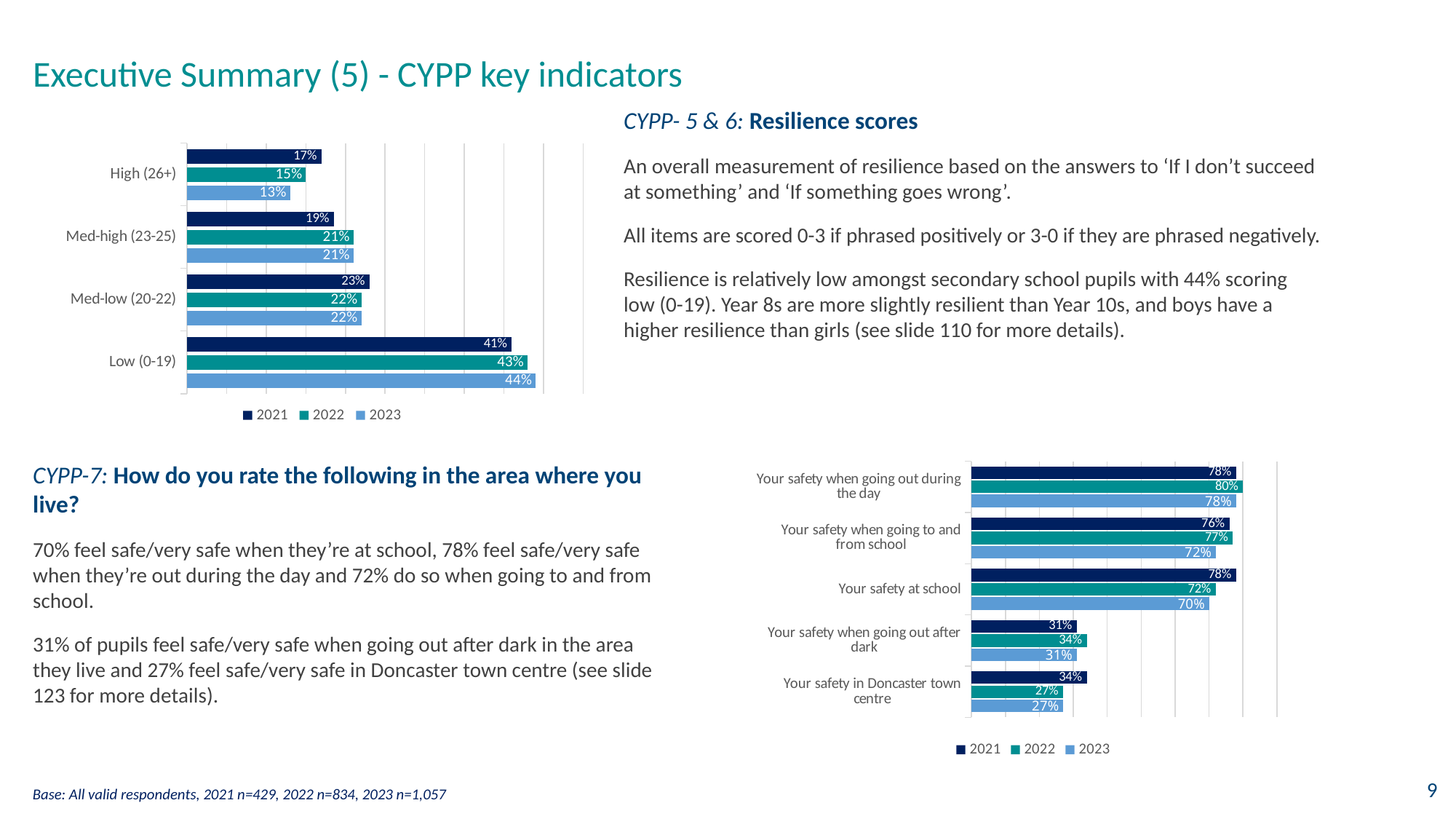
In the bottom-right safety chart, which is larger: the 2021 value for 'Your safety at school' or the 2023 value for 'Your safety at school'? 2021 (78%) In the top-left resilience scores chart, which category has the lowest 2023 value? High (26+) In the top-left resilience scores chart, what is the difference between the 2021 and 2023 values for High (26+)? 4% In the bottom-right safety chart, what is the 2022 value for 'Your safety when going out during the day'? 80% In the bottom-right safety chart, what is the 2023 value for 'Your safety in Doncaster town centre'? 27% In the bottom-right safety chart, which category has the lowest 2021 value? Your safety when going out after dark What kind of chart is the bottom-right safety chart? Bar chart How many series does the legend of the top-left resilience scores chart list? 3 How many categories are shown in the bottom-right safety chart? 5 In the top-left resilience scores chart, what is the 2023 value for Low (0-19)? 44% In the top-left resilience scores chart, what is the 2021 value for High (26+)? 17% In the top-left resilience scores chart, which category has the highest 2022 value? Low (0-19)